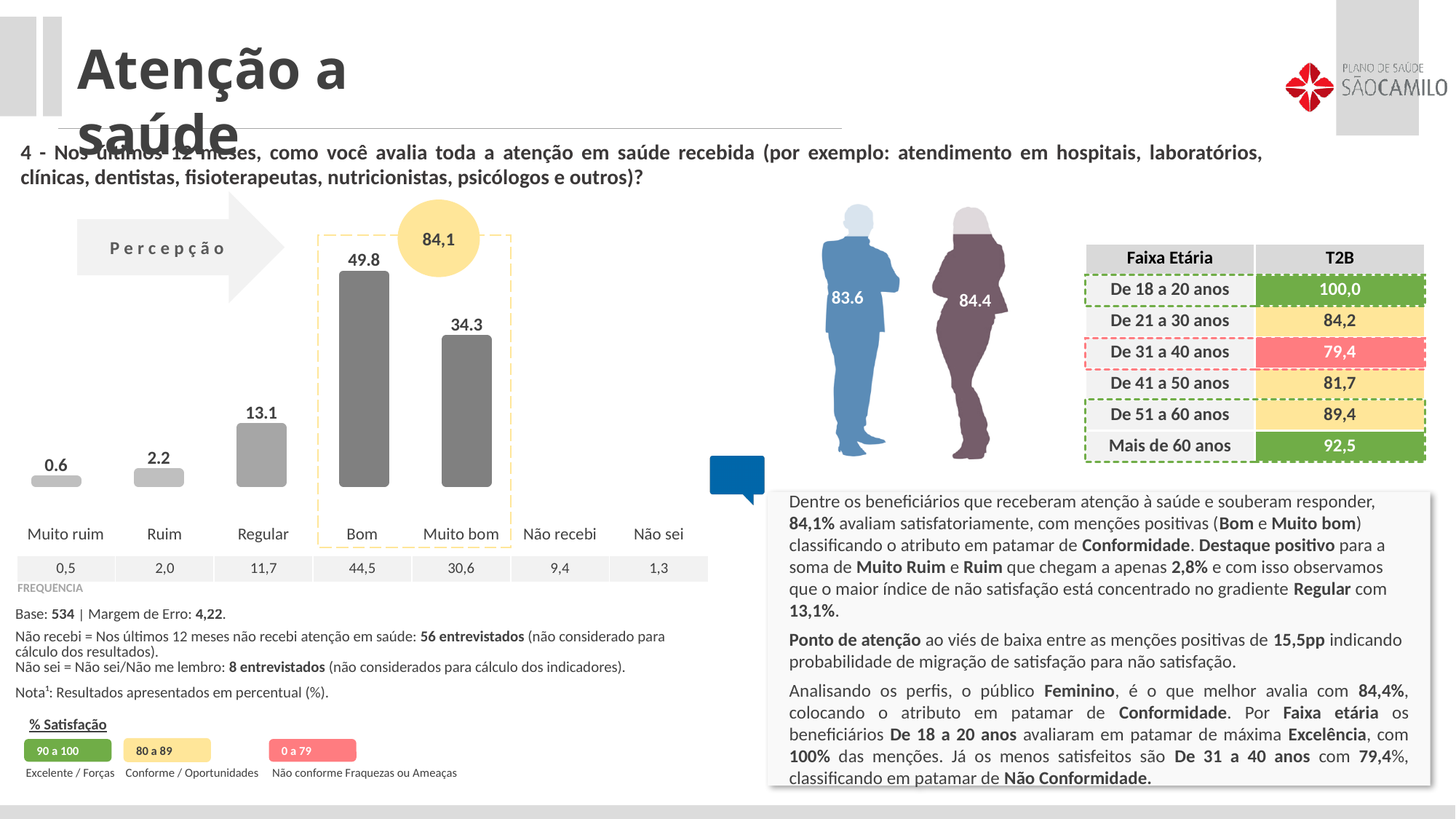
What is the value shown for the Muito bom bar in the chart? 34.3 What is the difference between the Bom and Muito bom bars in the chart? 15.5 What is the difference between the Regular and Ruim bars in the chart? 10.9 What is the value shown for the Bom bar in the chart? 49.8 Which bar is taller in the chart, Regular or Muito bom? Muito bom How many bars are plotted in the chart? 5 Which category has the lowest bar in the chart? Muito ruim What kind of chart is shown on the slide? Bar chart Do the bar values rise or fall from Muito ruim to Bom along the x axis? Rise Which category has the highest bar in the chart? Bom What is the value shown for the Regular bar in the chart? 13.1 What is the value shown for the Muito ruim bar in the chart? 0.6